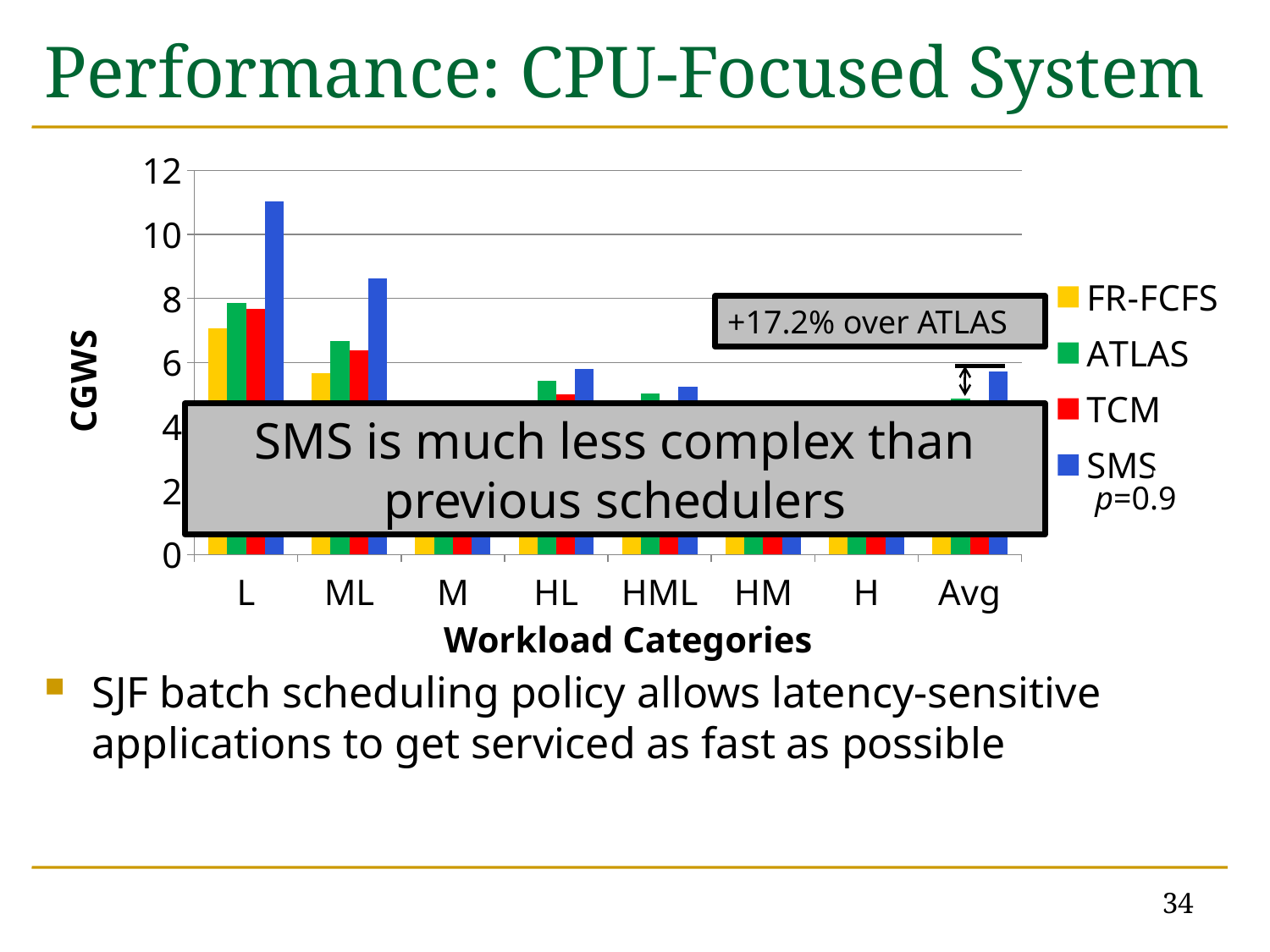
Is the FR-FCFS value for workload category ML greater or less than 6? less Is the SMS value for workload category L greater or less than 10? greater How many workload categories are shown on the x axis? 8 Which series has the highest value for workload category L? SMS What kind of chart is shown on the slide? bar chart What is the label on the y axis of the chart? CGWS How many series does the legend list? 4 Is the FR-FCFS value for workload category L greater or less than 6? greater Which series has the highest value for workload category ML? SMS For workload category L, which is larger: the SMS value or the ATLAS value? SMS What improvement over ATLAS does the annotation on the chart state? +17.2%